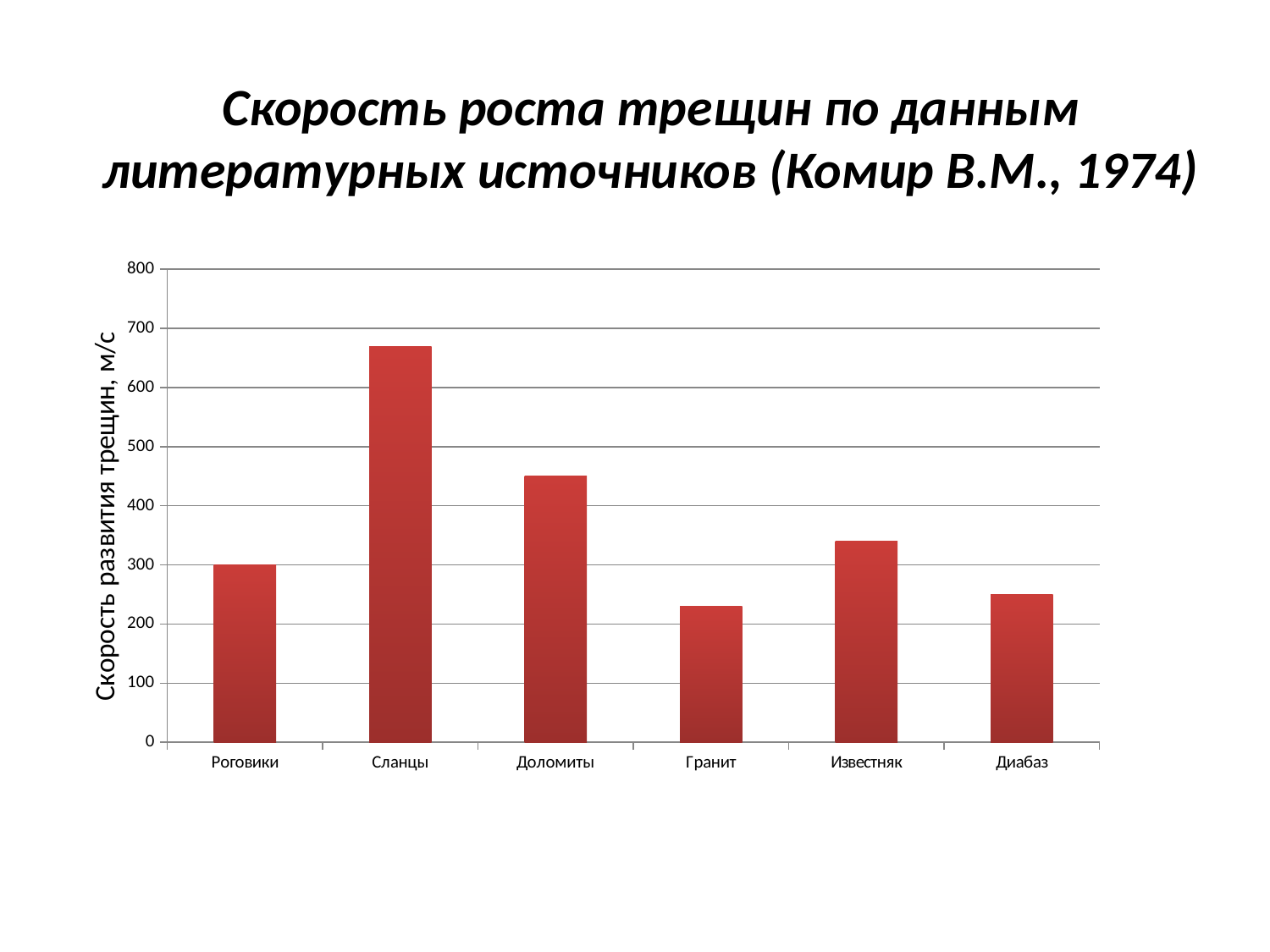
Which has a larger value, Роговики or Сланцы? Сланцы What is the highest value shown on the vertical axis of the chart? 800 What kind of chart is shown on the slide? bar chart Which rock type has the highest crack growth speed in the chart? Сланцы Which has a larger value, Доломиты or Известняк? Доломиты Is the value for Сланцы greater or less than 600? greater How many rock types are shown on the x axis of the chart? 6 Is the value for Известняк greater or less than 300? greater Is the value for Доломиты greater or less than 400? greater What is the label of the vertical axis of the chart? Скорость развития трещин, м/с